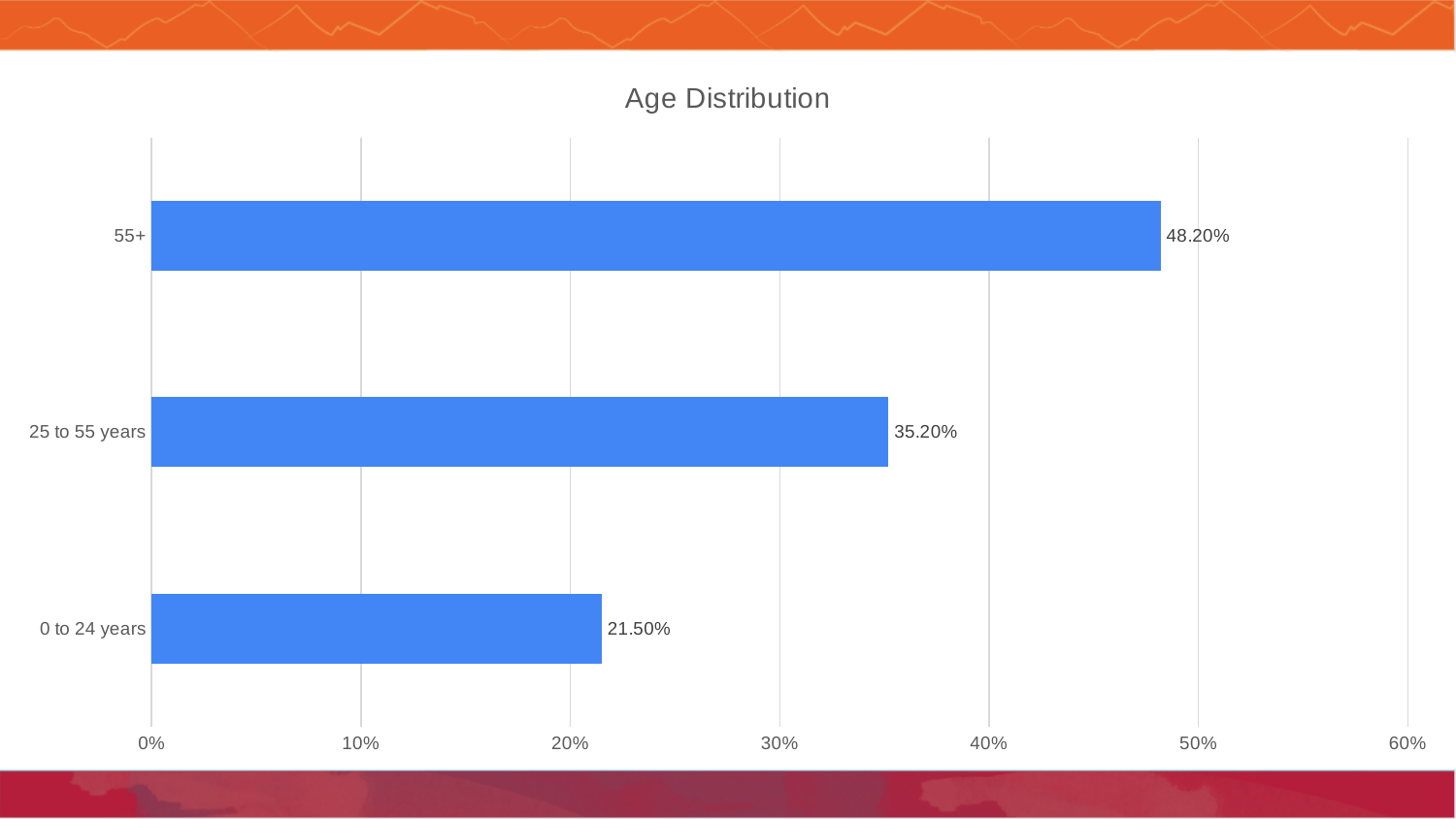
Which age group has the highest value? 55+ Is the value for 25 to 55 years greater or less than 30%? greater What is the value for the 0 to 24 years age group? 21.50% What is the value for the 25 to 55 years age group? 35.20% What is the difference between the values for 55+ and 0 to 24 years? 26.70% How many age groups are shown in the chart? 3 What is the title of the chart? Age Distribution Which age group has the lowest value? 0 to 24 years What is the difference between the values for 55+ and 25 to 55 years? 13.00% What is the value for the 55+ age group? 48.20% What kind of chart is shown on the slide? Bar chart Which is larger, the value for 25 to 55 years or the value for 0 to 24 years? 25 to 55 years